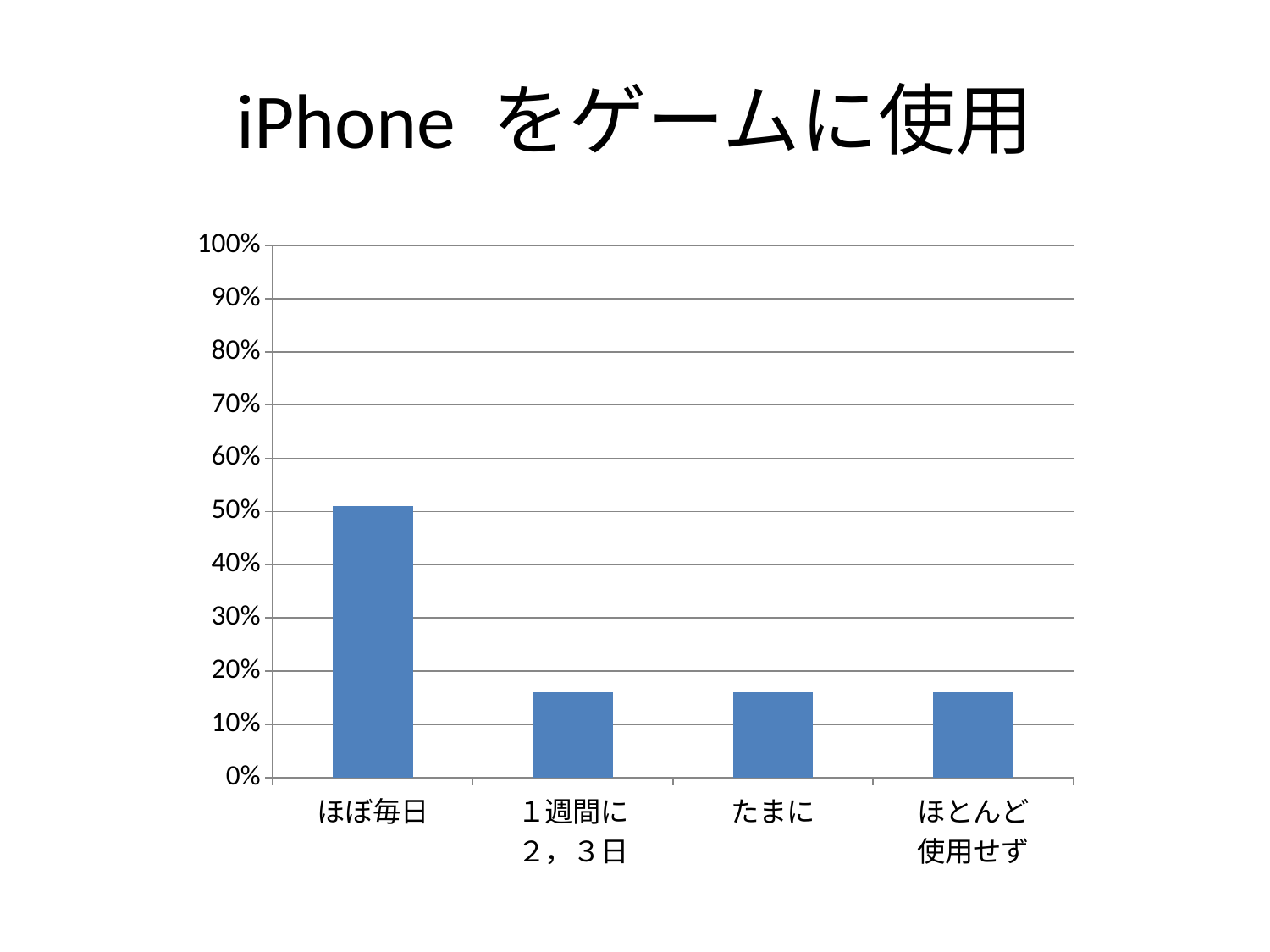
What is the highest value shown on the y axis of the chart? 100% Is the value for ほぼ毎日 greater or less than 60%? less Is the value for ほぼ毎日 greater or less than 40%? greater Which category has the highest value in the chart? ほぼ毎日 Is the value for ほとんど使用せず greater or less than 10%? greater Which is larger, the value for ほぼ毎日 or the value for たまに? ほぼ毎日 What is the title of the slide containing the chart? iPhone をゲームに使用 What kind of chart is shown on the slide? bar chart How many categories are shown on the x axis of the chart? 4 Which is larger, the value for ほとんど使用せず or the value for ほぼ毎日? ほぼ毎日